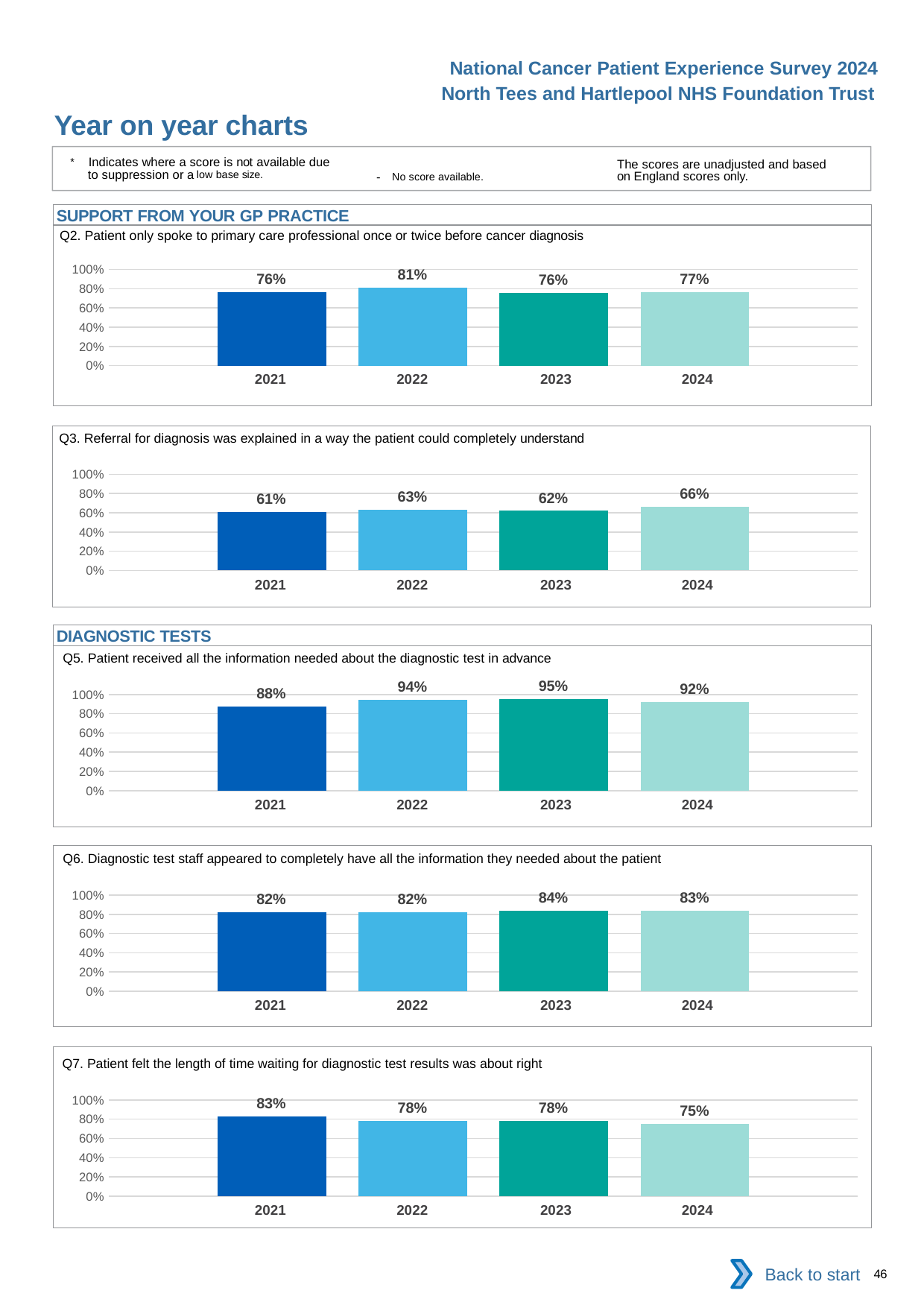
In the Q2 chart, what is the value for 2022? 81% In the Q2 chart, is the value for 2023 greater or less than 60%? greater In the Q7 chart, what is the difference between the 2021 and 2024 values? 8% What kind of chart is the Q2 chart? bar chart In the Q5 chart, which year has the lowest value? 2021 In the Q7 chart, do the values rise or fall from 2021 to 2024? fall In the Q6 chart, which is larger, the value for 2023 or the value for 2024? 2023 How many bars are in the Q6 chart? 4 In the Q5 chart, what is the value for 2023? 95% In the Q3 chart, what is the difference between the 2024 and 2021 values? 5% In the Q3 chart, which year has the highest value? 2024 What is the section heading above the Q5 chart? DIAGNOSTIC TESTS